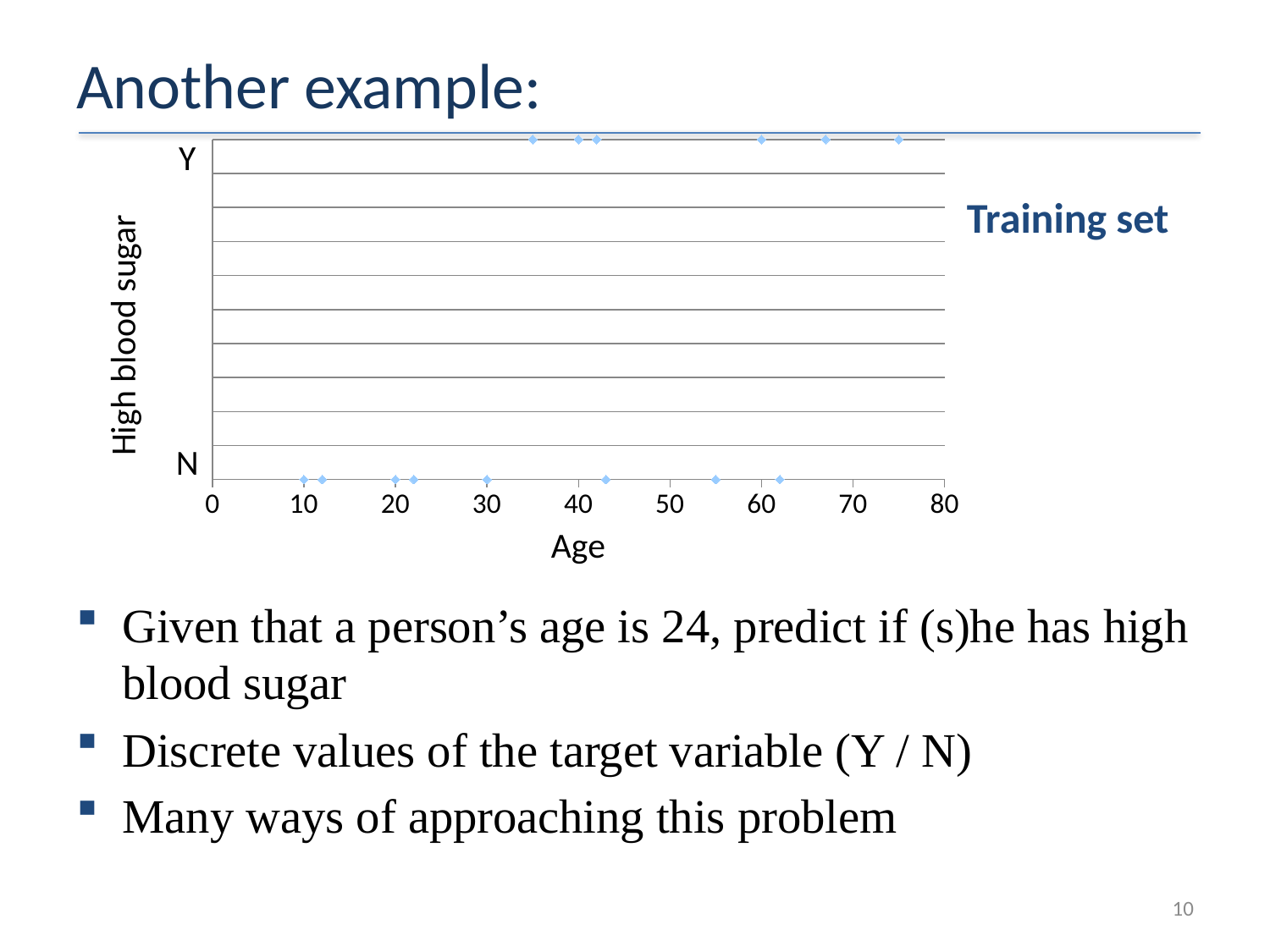
How many data points are plotted at the N level of the chart? 8 Is the age of the youngest person with high blood sugar Y greater or less than 30? greater What kind of chart is shown on the slide? scatter chart What high blood sugar value does the rightmost (oldest) point in the chart have? Y What is the label of the x axis of the chart? Age What is the label of the y axis of the chart? High blood sugar How many data points are plotted in the chart in total? 14 How many data points are plotted at the Y level of the chart? 6 Is the age of the oldest person with high blood sugar N greater or less than 70? less What high blood sugar value does the leftmost (youngest) point in the chart have? N Is the age of the oldest person in the training set greater or less than 70? greater Are there more points at the Y level or at the N level? N